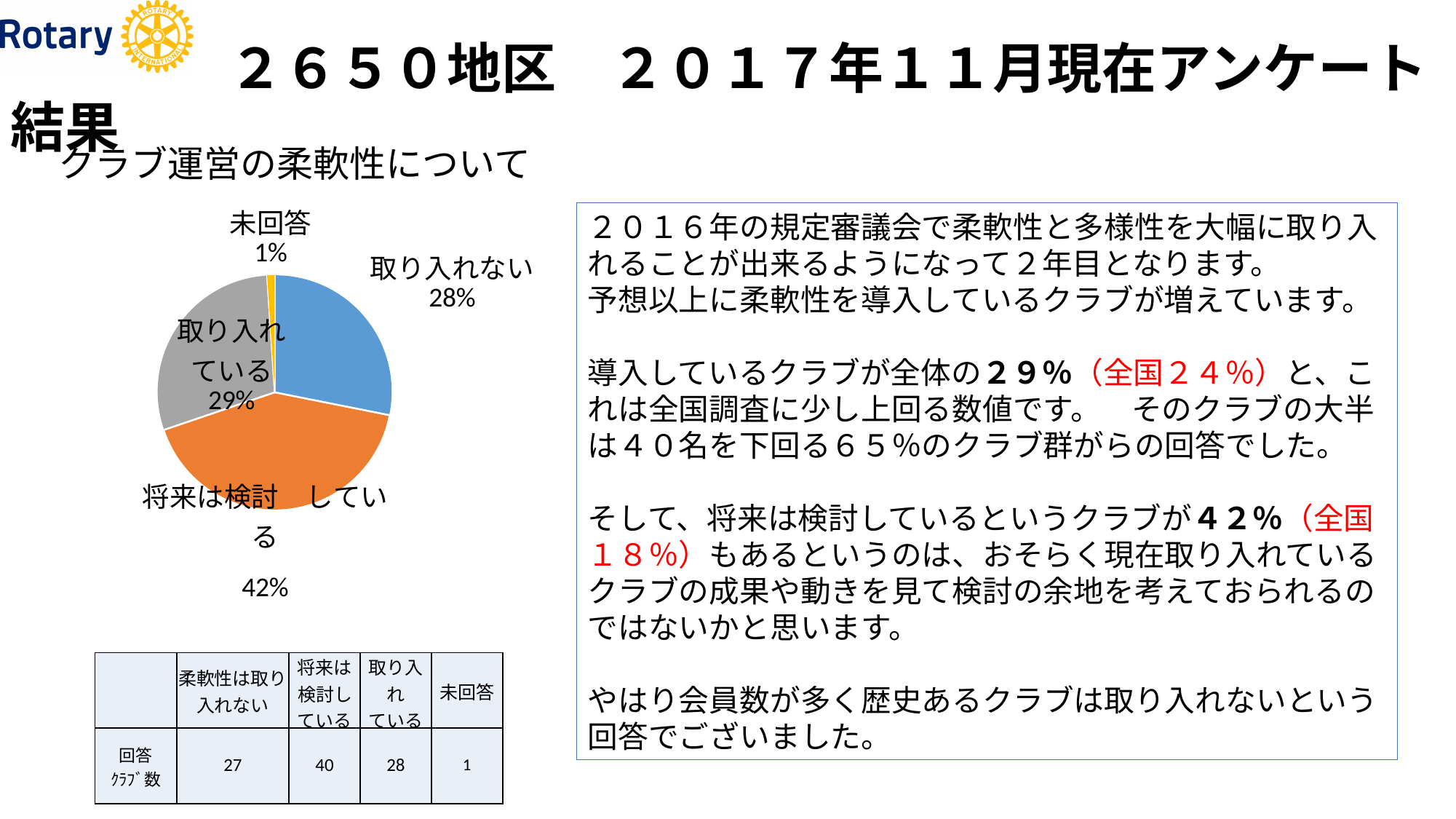
How many slices does the pie chart have? 4 What percentage does the pie chart show for 将来は検討している? 42% Which is larger in the pie chart, 将来は検討している or 取り入れない? 将来は検討している What percentage does the pie chart show for 取り入れない? 28% Which category has the largest slice in the pie chart? 将来は検討している What kind of chart is shown on the slide? pie chart What is the difference in percentage points between 将来は検討している and 取り入れない in the pie chart? 14 What colour is the 将来は検討している slice in the pie chart? orange What colour is the 取り入れている slice in the pie chart? gray What percentage does the pie chart show for 取り入れている? 29% What percentage does the pie chart show for 未回答? 1% Which category has the smallest slice in the pie chart? 未回答